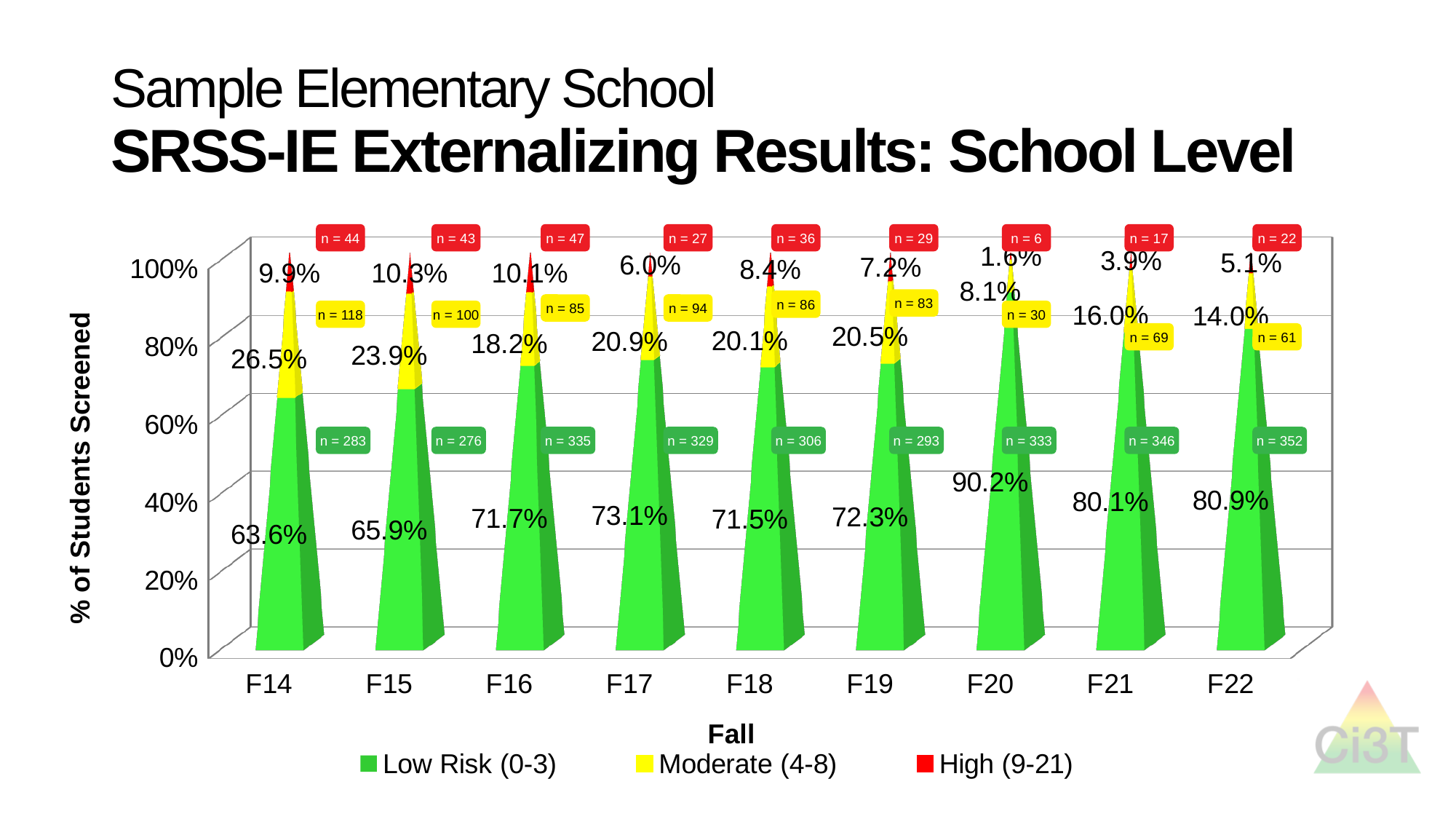
What percentage of students were in the High (9-21) category in F17? 6.0% What percentage of students were in the Moderate (4-8) category in F20? 8.1% How many percentage points higher is the Low Risk (0-3) value in F22 than in F14? 17.3 percentage points What percentage of students were in the Low Risk (0-3) category in F14? 63.6% What is the n value shown for the Low Risk (0-3) group in F22? n = 352 What kind of chart is shown on the slide? Stacked bar chart Which term has the larger Moderate (4-8) percentage, F15 or F16? F15 In which fall term was the Moderate (4-8) percentage highest? F14 In which fall term was the High (9-21) percentage lowest? F20 How many series does the legend list? 3 How many fall terms are shown on the x axis? 9 In which fall term was the Low Risk (0-3) percentage highest? F20